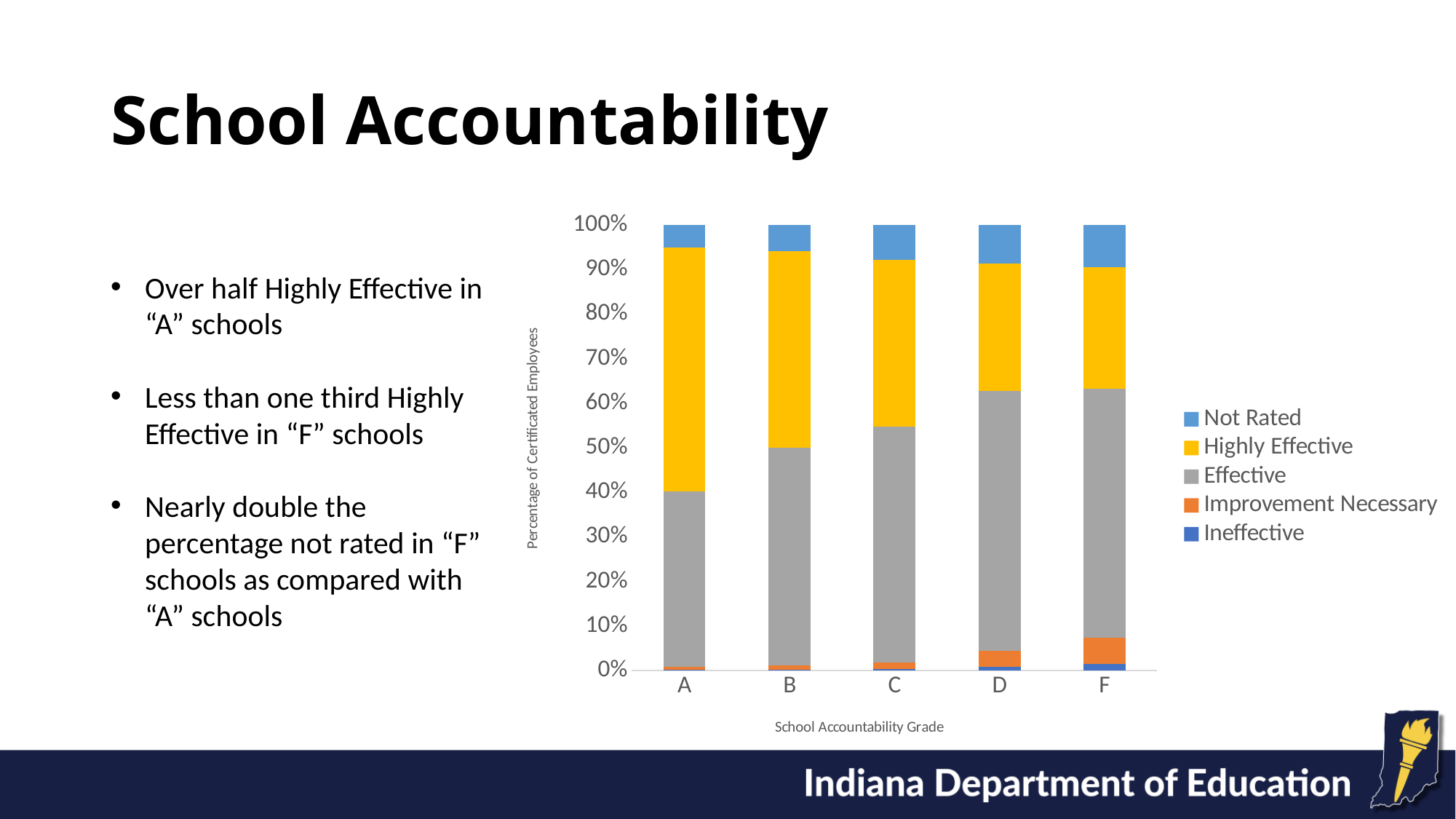
Is the Highly Effective share for grade F schools greater or less than 30%? less Which grade has the largest Improvement Necessary share? F How many series does the legend list? 5 How many school accountability grades are shown on the x axis? 5 Is the Highly Effective share for grade A schools greater or less than 50%? greater Which grade has the larger Highly Effective share, A or F? A What is the title of the x axis? School Accountability Grade What kind of chart is shown on the slide? Stacked bar chart Does the Highly Effective share rise or fall moving from grade A to grade F? fall Which grade has the larger Not Rated share, A or F? F What is the title of the y axis? Percentage of Certificated Employees Is the Effective share for grade A schools greater or less than 50%? less